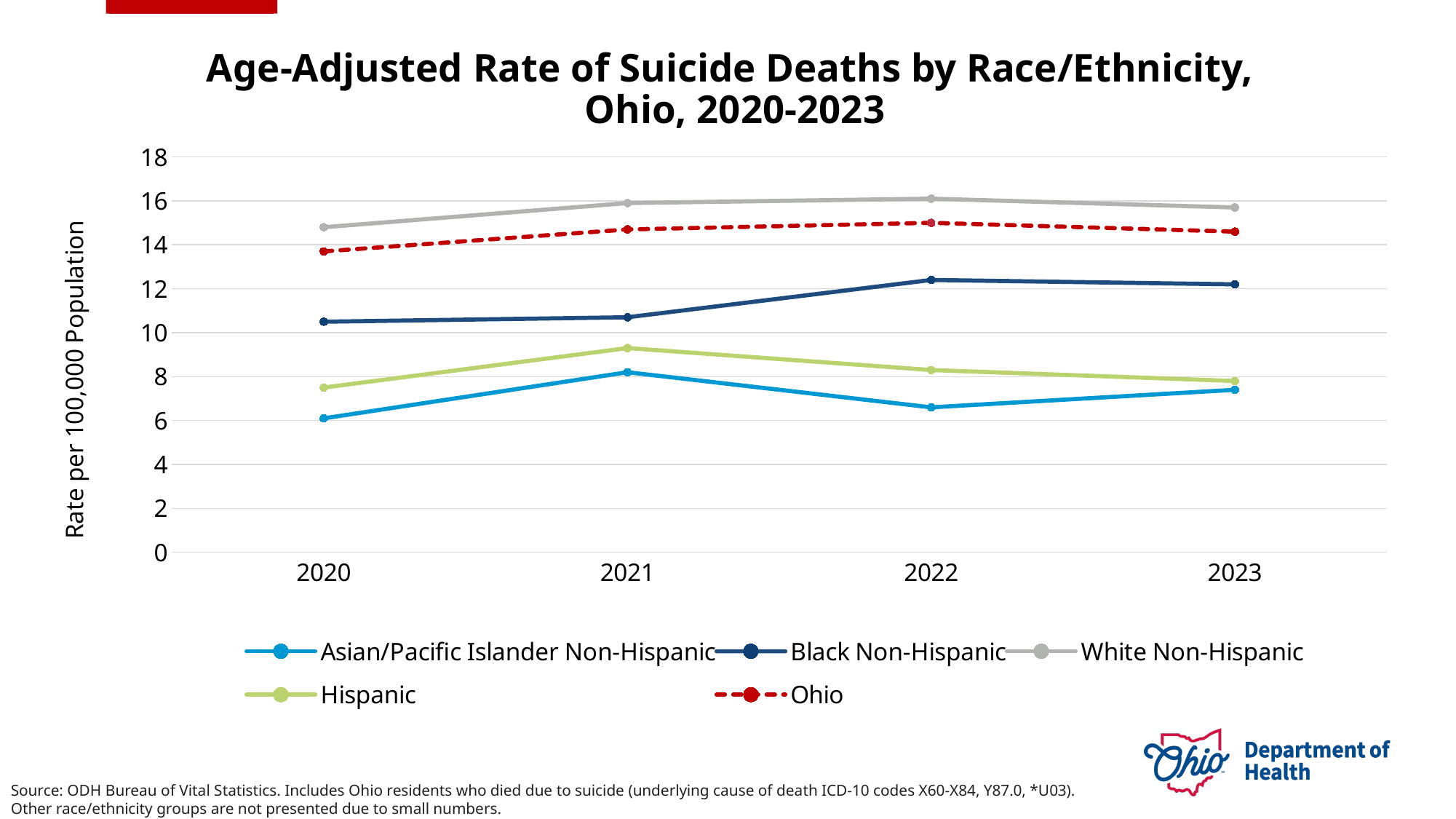
What kind of chart is shown on the slide? line chart Which race/ethnicity group has the lowest rate in 2022? Asian/Pacific Islander Non-Hispanic In 2021, which is larger: the rate for Black Non-Hispanic or the rate for Hispanic? Black Non-Hispanic Which race/ethnicity group has the lowest rate in 2020? Asian/Pacific Islander Non-Hispanic Does the rate for Black Non-Hispanic rise or fall from 2020 to 2022? rise Is the value for Asian/Pacific Islander Non-Hispanic in 2020 greater or less than 8? less In 2023, which is larger: the rate for White Non-Hispanic or the rate for Ohio? White Non-Hispanic Which series is drawn with a dashed line? Ohio How many series does the legend list? 5 Is the value for White Non-Hispanic in 2022 greater or less than 14? greater How many years are plotted along the x axis? 4 Which race/ethnicity group has the highest rate in 2022? White Non-Hispanic